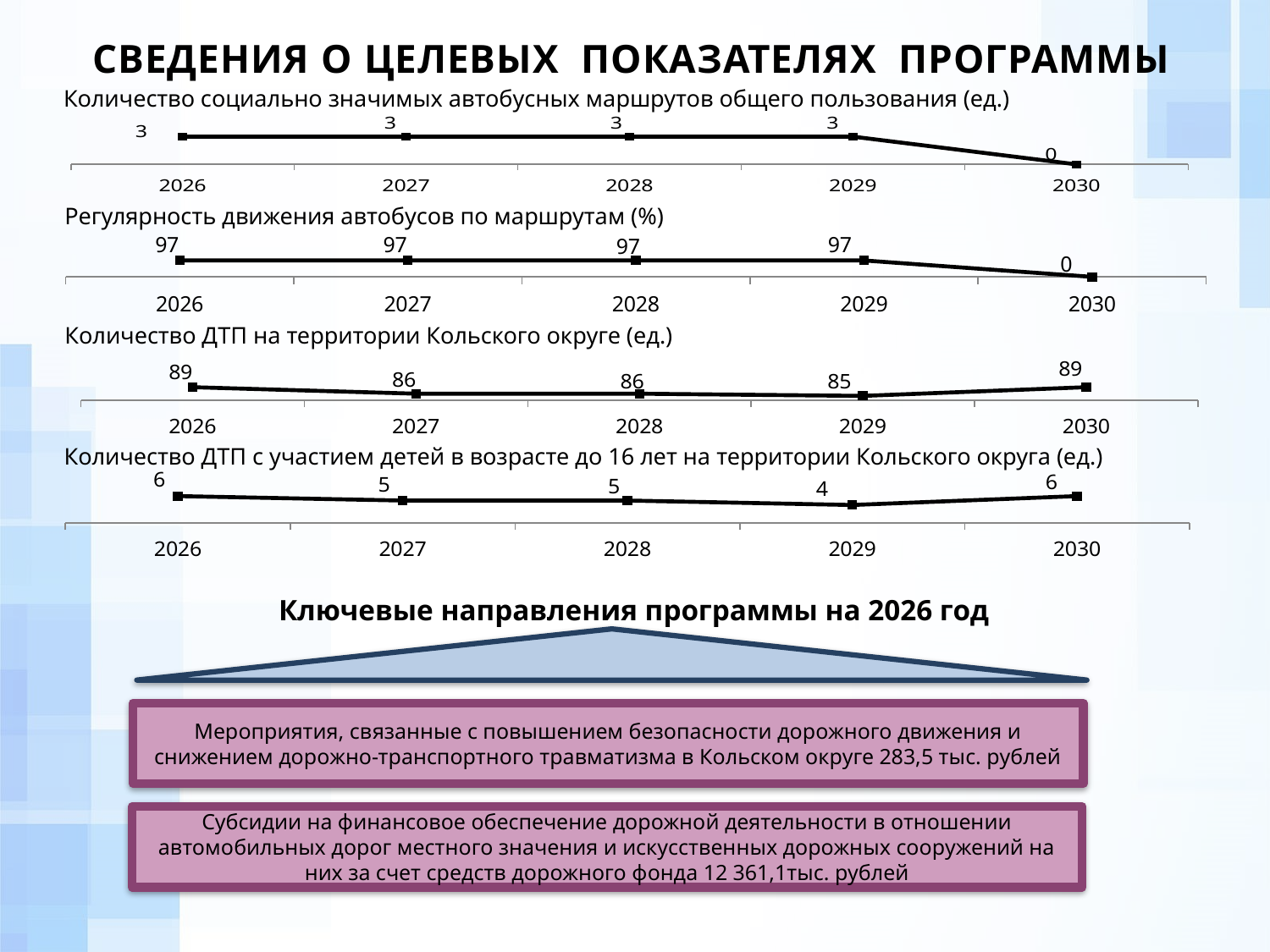
In the chart 'Количество социально значимых автобусных маршрутов общего пользования (ед.)', what is the value for 2028? 3 In the chart 'Регулярность движения автобусов по маршрутам (%)', what is the value for 2027? 97 How many data points are plotted in the chart 'Количество ДТП с участием детей в возрасте до 16 лет на территории Кольского округа (ед.)'? 5 In the chart 'Количество ДТП с участием детей в возрасте до 16 лет на территории Кольского округа (ед.)', which year has the lowest value? 2029 In the chart 'Регулярность движения автобусов по маршрутам (%)', which year has the lowest value? 2030 In the chart 'Количество ДТП с участием детей в возрасте до 16 лет на территории Кольского округа (ед.)', what is the value for 2029? 4 In the chart 'Количество ДТП на территории Кольского округе (ед.)', which is larger, the value for 2027 or the value for 2030? 2030 In the chart 'Количество ДТП на территории Кольского округе (ед.)', what is the difference between the values for 2026 and 2029? 4 In the chart 'Количество социально значимых автобусных маршрутов общего пользования (ед.)', what is the value for 2030? 0 What type of chart is 'Регулярность движения автобусов по маршрутам (%)'? Line chart How many charts are shown on the slide? 4 In the chart 'Количество ДТП на территории Кольского округе (ед.)', what is the value for 2029? 85